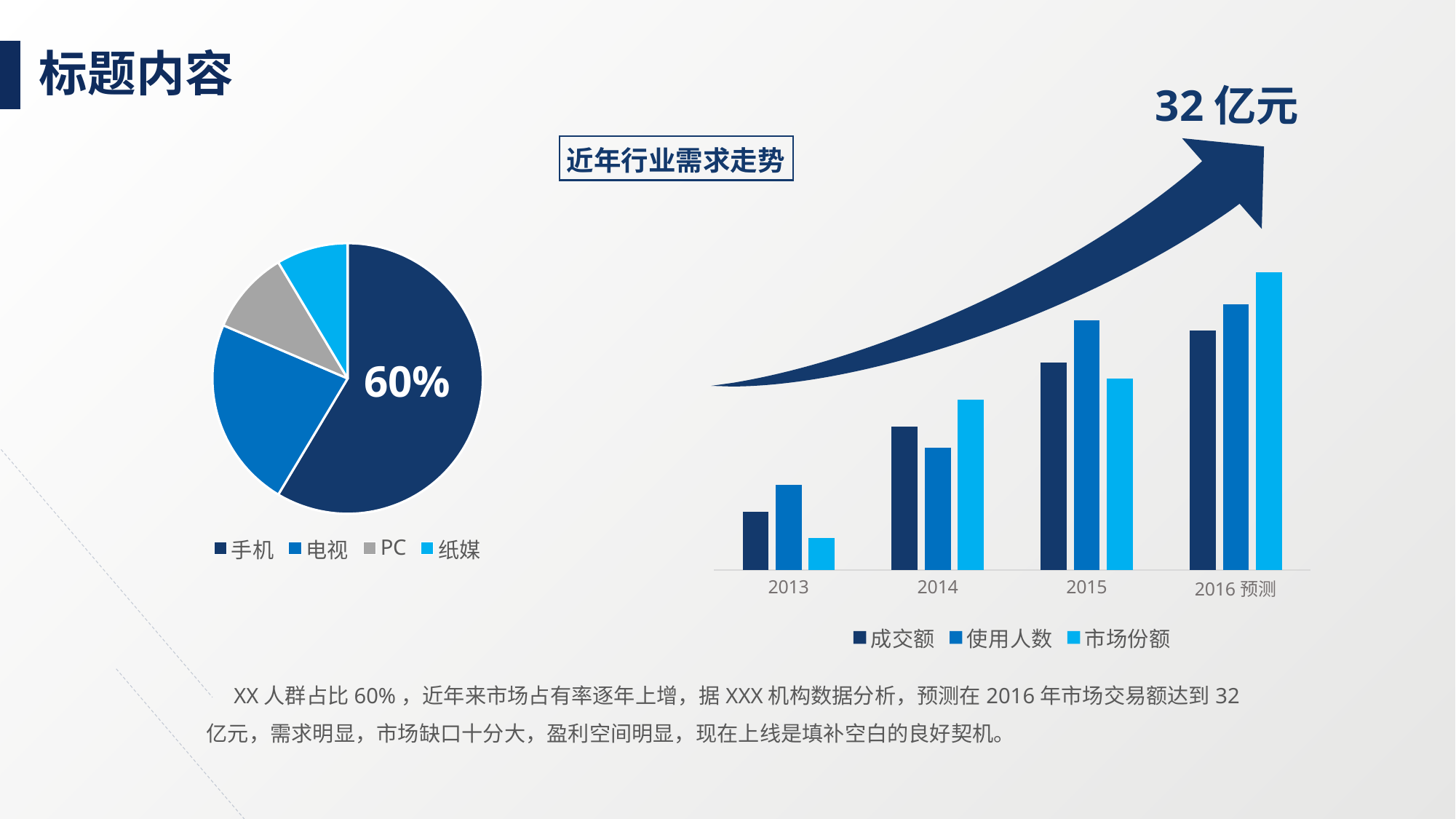
What kind of chart is the chart on the left of the slide? pie chart In the chart titled 近年行业需求走势, do the 成交额 values rise or fall from 2013 to 2016 预测? rise What kind of chart is the chart titled 近年行业需求走势? bar chart In the chart titled 近年行业需求走势, which series has the tallest bar in 2013? 使用人数 In the chart titled 近年行业需求走势, is the 市场份额 bar for 2013 larger or smaller than the 市场份额 bar for 2016 预测? smaller How many categories are shown on the x axis of the chart titled 近年行业需求走势? 4 How many series does the legend of the chart titled 近年行业需求走势 list? 3 In the chart titled 近年行业需求走势, which year has the lowest 成交额 bar? 2013 In the pie chart on the left, which category has the largest slice? 手机 In the chart titled 近年行业需求走势, which year has the highest 市场份额 bar? 2016 预测 How many categories does the legend of the pie chart on the left list? 4 In the pie chart on the left, what share does the 手机 slice have? 60%